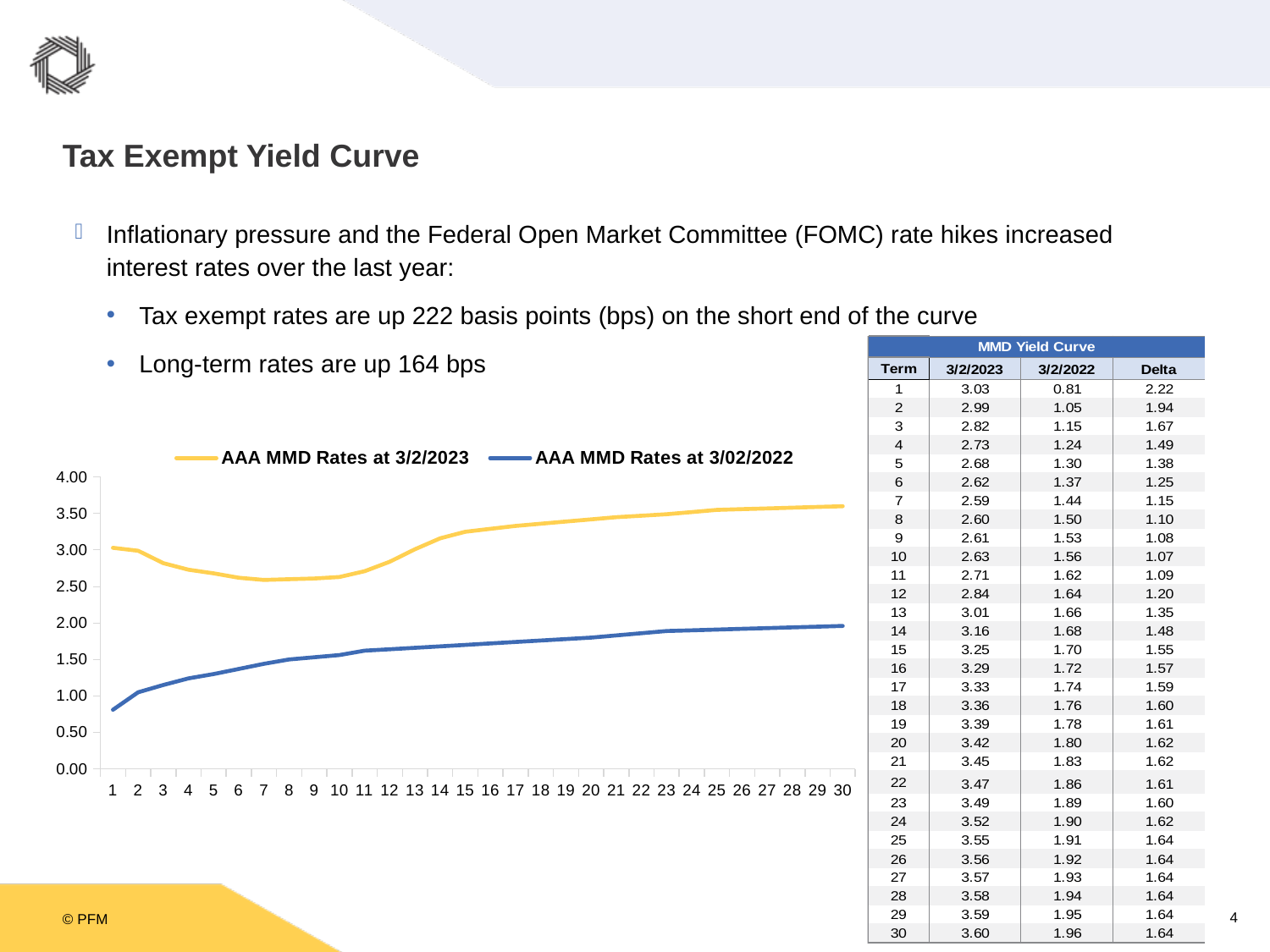
What type of chart is shown on the slide? line chart What colour is the line for AAA MMD Rates at 3/2/2023? yellow At which term is the AAA MMD rate at 3/2/2023 lowest, according to the table? 7 According to the MMD Yield Curve table, what is the AAA MMD rate at term 30 on 3/2/2022? 1.96 Is the value of the AAA MMD Rates at 3/02/2022 line at term 1 greater or less than 1.00? less How many terms are plotted along the x axis of the chart? 30 What is the delta between the 3/2/2023 and 3/2/2022 rates at term 1, as shown in the table? 2.22 At term 15, which series has the higher rate: AAA MMD Rates at 3/2/2023 or AAA MMD Rates at 3/02/2022? AAA MMD Rates at 3/2/2023 According to the MMD Yield Curve table, what is the AAA MMD rate at term 1 on 3/2/2023? 3.03 Does the AAA MMD Rates at 3/02/2022 line generally rise or fall as the term increases from 1 to 30? rise How many series does the chart legend list? 2 At which term is the AAA MMD rate at 3/2/2023 highest? 30